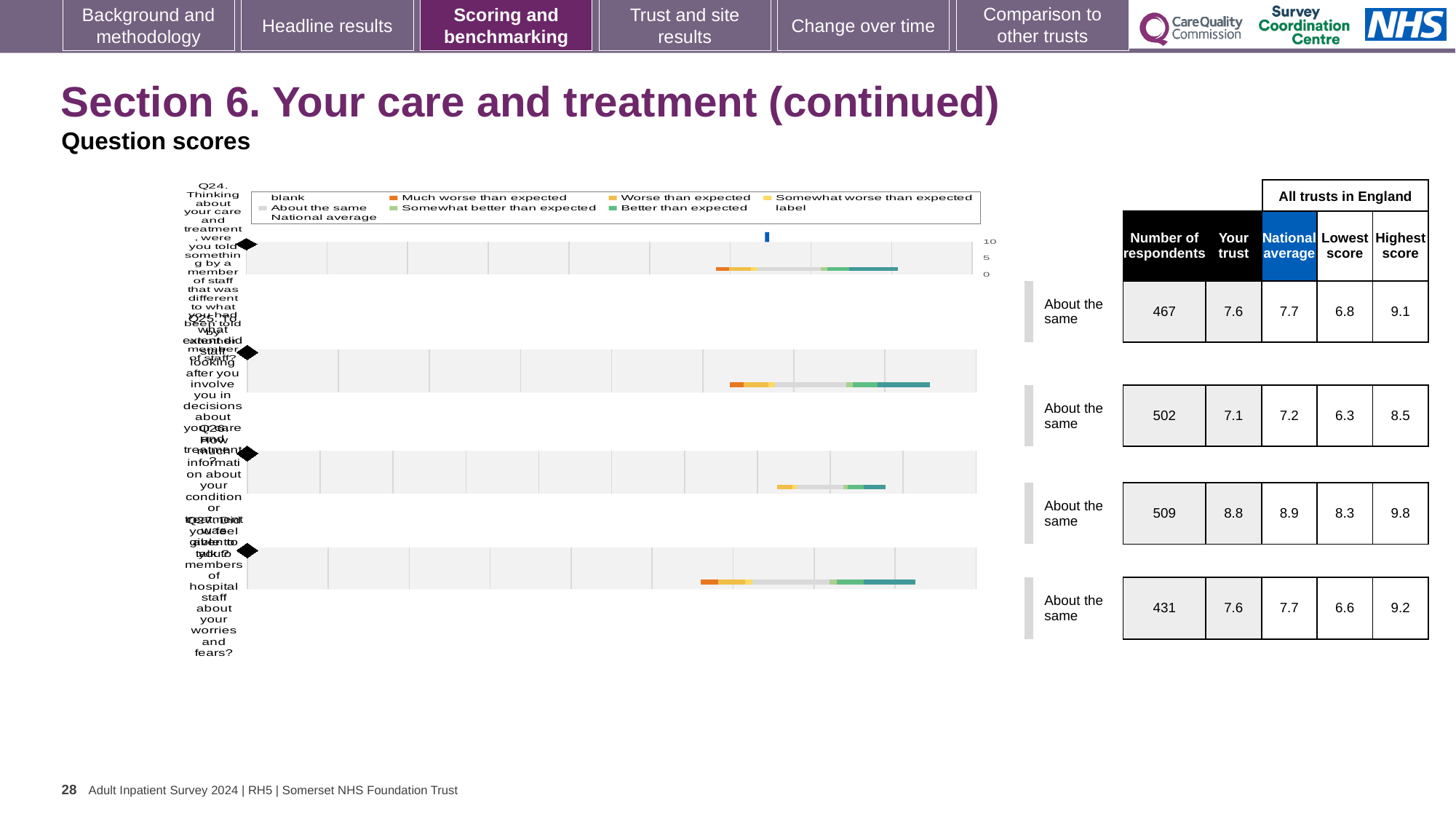
For Q24, which is larger: the 'Your trust' score or the national average? National average For Q26, what is the difference between the highest score (9.8) and the lowest score (8.3) in the table? 1.5 In the table, what is the national average for Q26 (how much information about your condition or treatment was given to you)? 8.9 In the table, what is the highest score across all trusts in England for Q27 (able to talk to hospital staff about worries and fears)? 9.2 Which of the four questions (Q24–Q27) has the highest 'Your trust' score in the table? Q26 In the table next to the charts, how many respondents are listed for Q24 (told something different by another member of staff)? 467 What kind of chart is used to show each question's benchmark result? Bar chart What benchmark category is shown beside the chart for Q25? About the same Which of the four questions (Q24–Q27) has the lowest 'Your trust' score in the table? Q25 How many question charts (Q24 to Q27) are shown on the slide? 4 In the table, what is the 'Your trust' score for Q25 (staff involving you in decisions about your care and treatment)? 7.1 In the chart legend, what colour represents 'Much worse than expected'? Orange